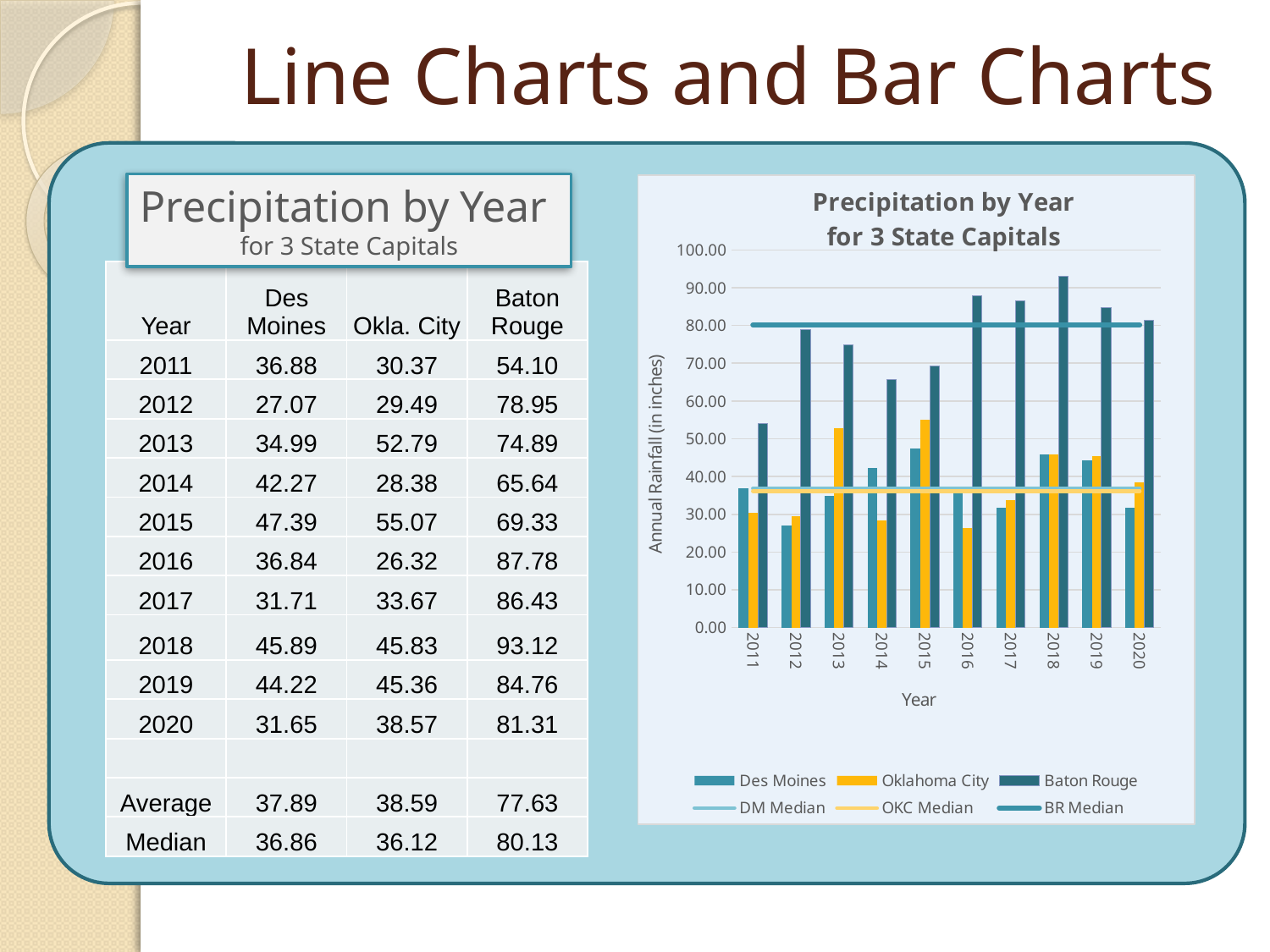
Do the Des Moines values rise or fall from 2018 to 2020? fall What is the label on the vertical axis of the chart? Annual Rainfall (in inches) How many years are shown along the x axis of the chart? 10 In which year is the Baton Rouge bar highest? 2018 In 2013, which is larger: the Oklahoma City bar or the Des Moines bar? Oklahoma City How many series does the chart legend list? 6 What kind of chart is shown on the slide? combination bar and line chart What is the difference between the Baton Rouge and Des Moines values for 2018? 47.23 In which year is the Des Moines bar lowest? 2012 Is the Baton Rouge value for 2016 greater or less than 80.00? greater Is the Oklahoma City value for 2016 greater or less than 30.00? less What is the Des Moines precipitation value for 2015? 47.39